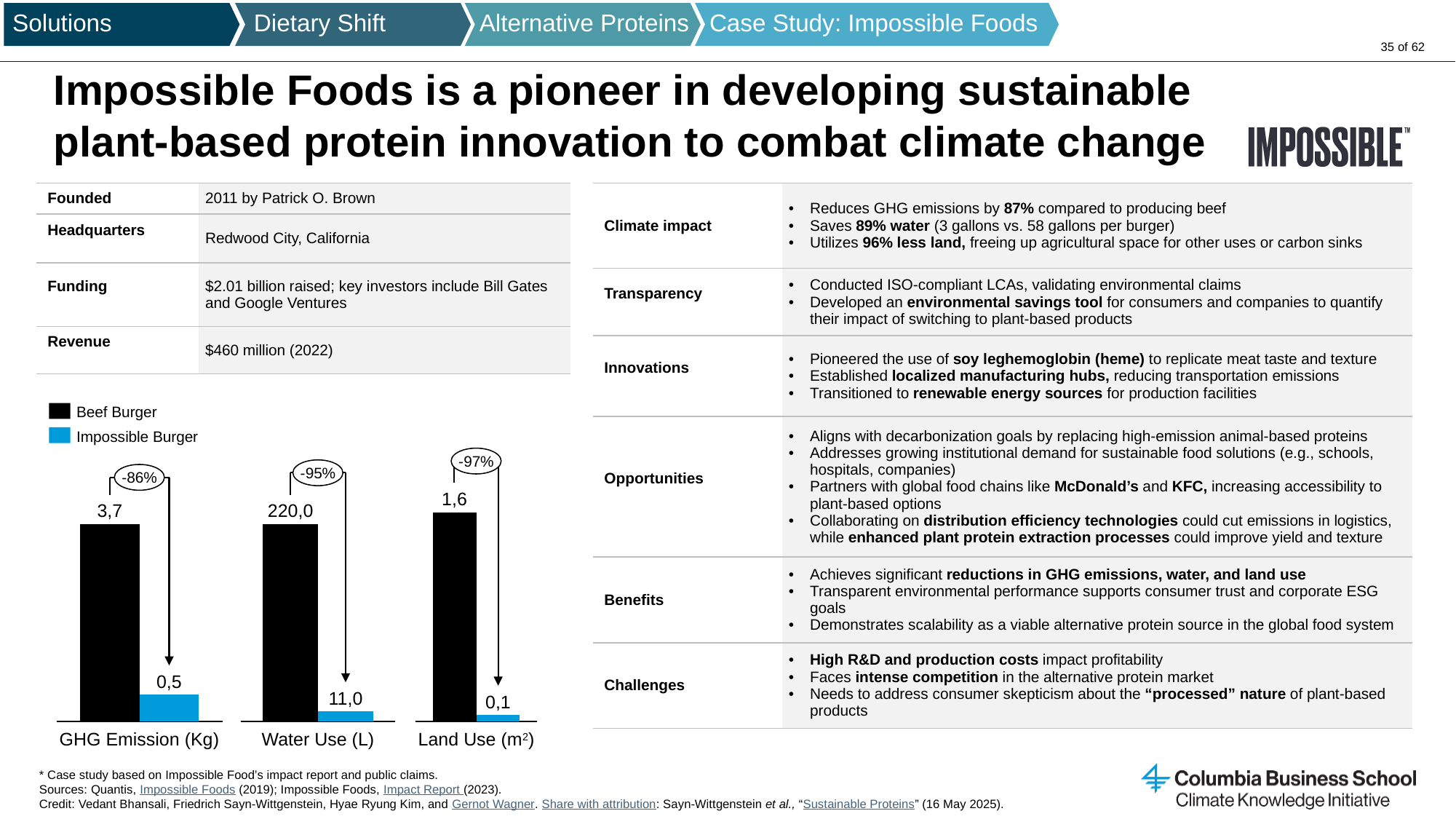
In the Land Use (m2) chart, what is the difference between the Beef Burger and Impossible Burger values? 1,5 What percentage reduction is shown above the Water Use (L) chart? -95% In the Land Use (m2) chart, what is the value for the Beef Burger? 1,6 How many series does the legend of the bar charts list? 2 In the Water Use (L) chart, what is the value for the Beef Burger? 220,0 In the Water Use (L) chart, which burger has the higher value? Beef Burger In the Land Use (m2) chart, what is the value for the Impossible Burger? 0,1 In the Water Use (L) chart, what is the value for the Impossible Burger? 11,0 In the GHG Emission (Kg) chart, what is the value for the Beef Burger? 3,7 In the GHG Emission (Kg) chart, what is the difference between the Beef Burger and Impossible Burger values? 3,2 What type of chart is used to show GHG Emission, Water Use and Land Use? Bar chart In the GHG Emission (Kg) chart, what is the value for the Impossible Burger? 0,5